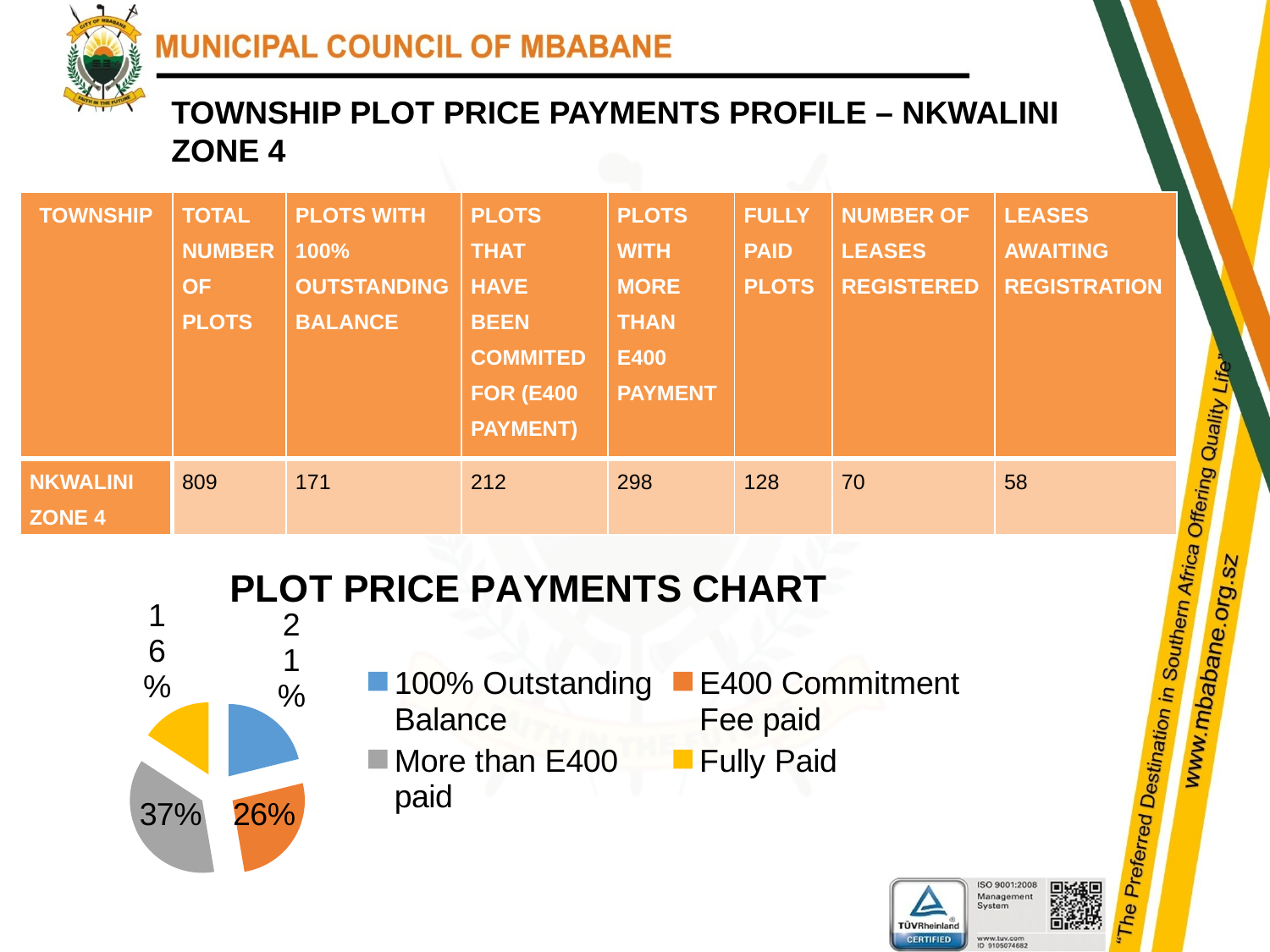
In the PLOT PRICE PAYMENTS CHART, what share of the pie is 'More than E400 paid'? 37% How many slices does the PLOT PRICE PAYMENTS CHART have? 4 In the PLOT PRICE PAYMENTS CHART, what share of the pie is 'Fully Paid'? 16% How many entries does the legend of the PLOT PRICE PAYMENTS CHART list? 4 Which category has the largest slice in the PLOT PRICE PAYMENTS CHART? More than E400 paid Which category has the smallest slice in the PLOT PRICE PAYMENTS CHART? Fully Paid What type of chart is the PLOT PRICE PAYMENTS CHART? pie chart In the PLOT PRICE PAYMENTS CHART, what is the difference in percentage points between 'More than E400 paid' and 'Fully Paid'? 21 In the PLOT PRICE PAYMENTS CHART, what share of the pie is '100% Outstanding Balance'? 21% In the PLOT PRICE PAYMENTS CHART, which is larger: 'E400 Commitment Fee paid' or '100% Outstanding Balance'? E400 Commitment Fee paid In the PLOT PRICE PAYMENTS CHART, what colour is the 'Fully Paid' slice? yellow